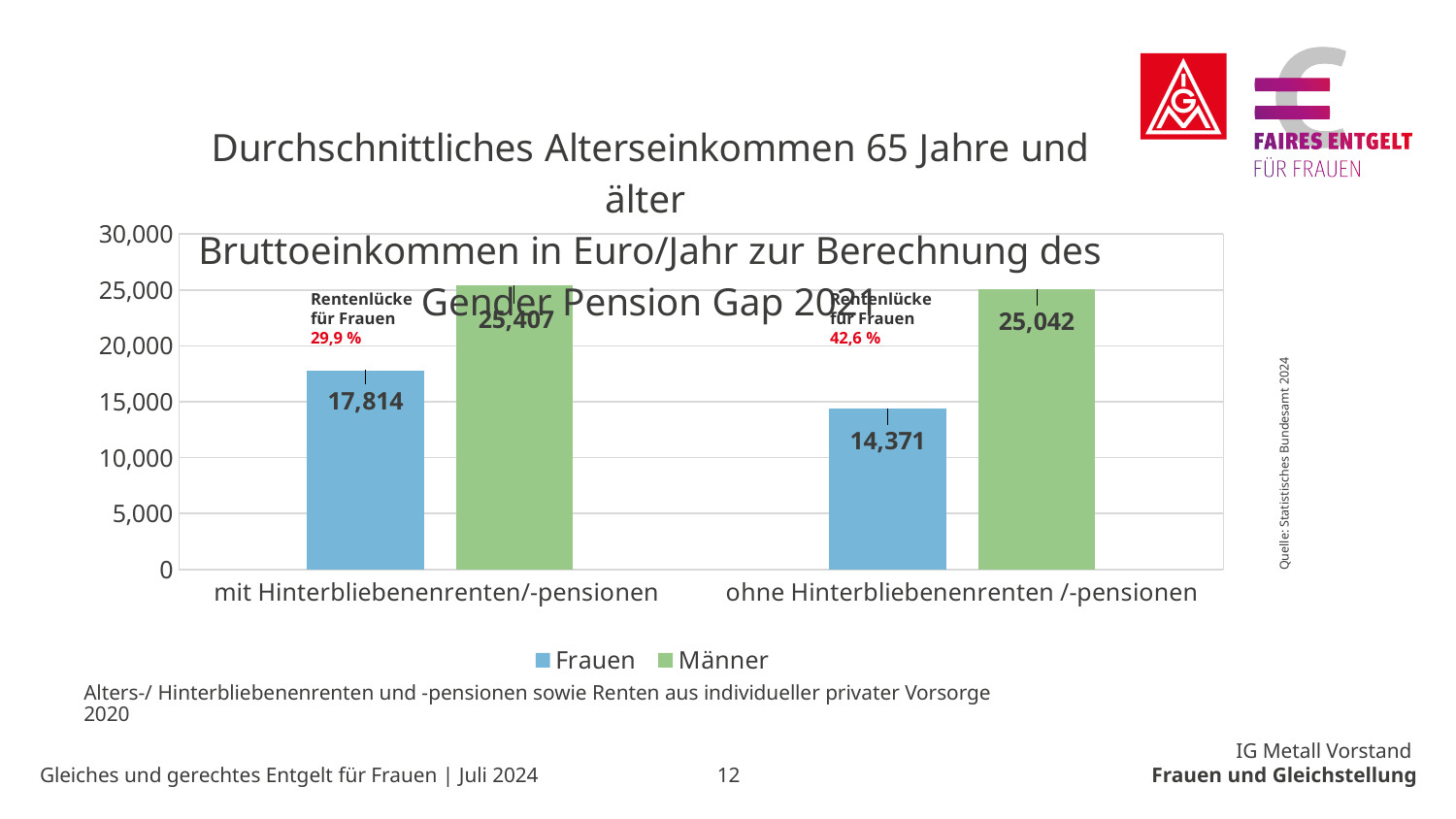
What is the value for Männer in the category 'ohne Hinterbliebenenrenten /-pensionen'? 25,042 Which is larger: the Frauen value with Hinterbliebenenrenten or the Frauen value without Hinterbliebenenrenten? mit Hinterbliebenenrenten/-pensionen What is the value for Frauen in the category 'mit Hinterbliebenenrenten/-pensionen'? 17,814 How many series does the legend list? 2 What kind of chart is shown on the slide? bar chart Which bar has the highest value in the chart? Männer, mit Hinterbliebenenrenten/-pensionen What Rentenlücke für Frauen percentage is shown for the category 'ohne Hinterbliebenenrenten /-pensionen'? 42,6 % Which bar has the lowest value in the chart? Frauen, ohne Hinterbliebenenrenten /-pensionen What is the value for Frauen in the category 'ohne Hinterbliebenenrenten /-pensionen'? 14,371 What is the difference between the Männer and Frauen values in the category 'mit Hinterbliebenenrenten/-pensionen'? 7,593 What is the difference between the Männer and Frauen values in the category 'ohne Hinterbliebenenrenten /-pensionen'? 10,671 What is the value for Männer in the category 'mit Hinterbliebenenrenten/-pensionen'? 25,407